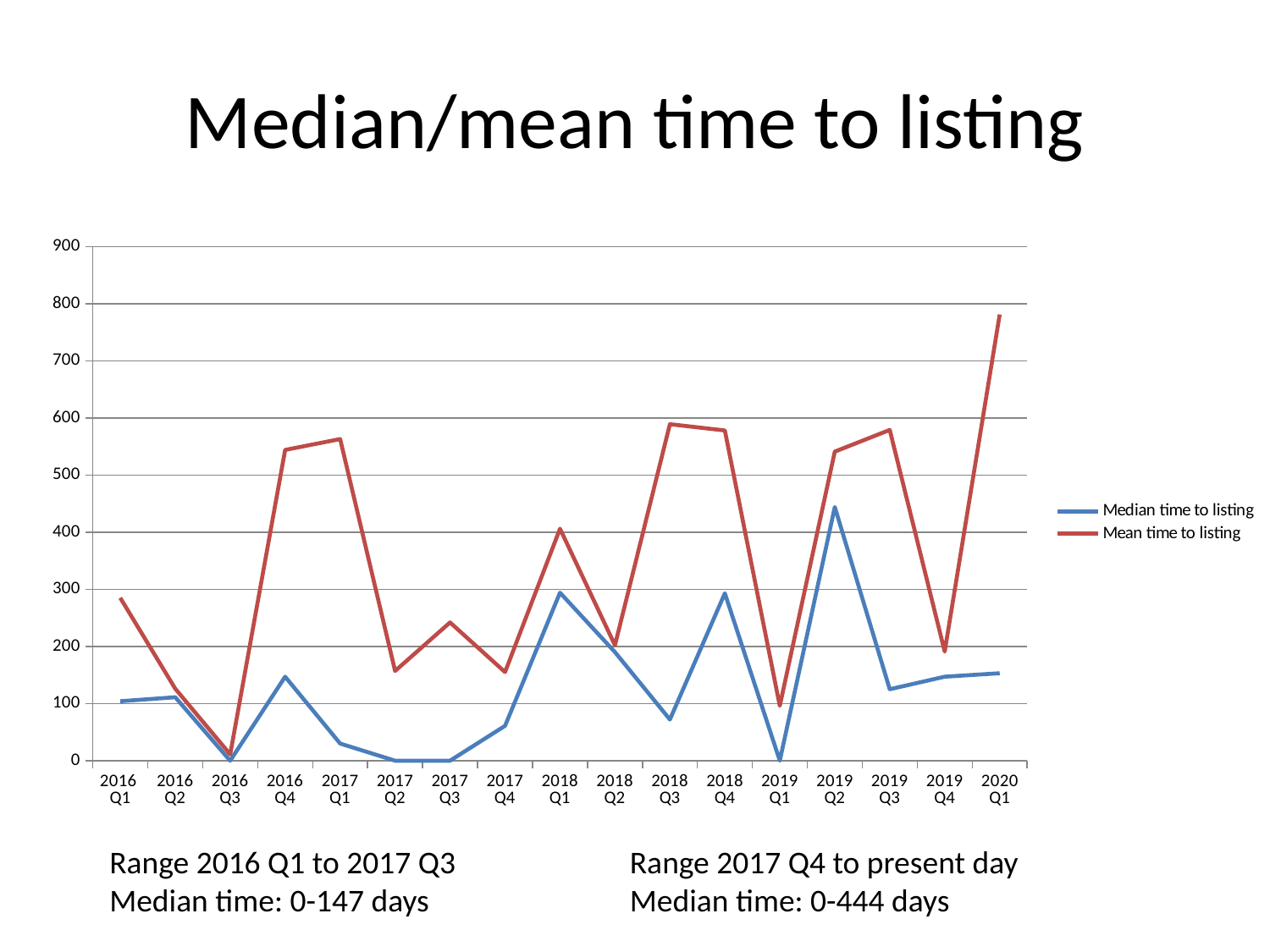
Is the Median time to listing for 2019 Q2 greater or less than 400? greater What kind of chart is shown on the slide? line chart Is the Mean time to listing for 2020 Q1 greater or less than 700? greater In which quarter is the Mean time to listing highest? 2020 Q1 How many series does the legend list? 2 What colour is the line for Mean time to listing? red In 2018 Q3, which is larger: the Mean time to listing or the Median time to listing? Mean time to listing In which quarter is the Mean time to listing lowest? 2016 Q3 How many quarters are plotted along the x axis? 17 In which quarter is the Median time to listing highest? 2019 Q2 Is the Mean time to listing for 2019 Q1 greater or less than 200? less